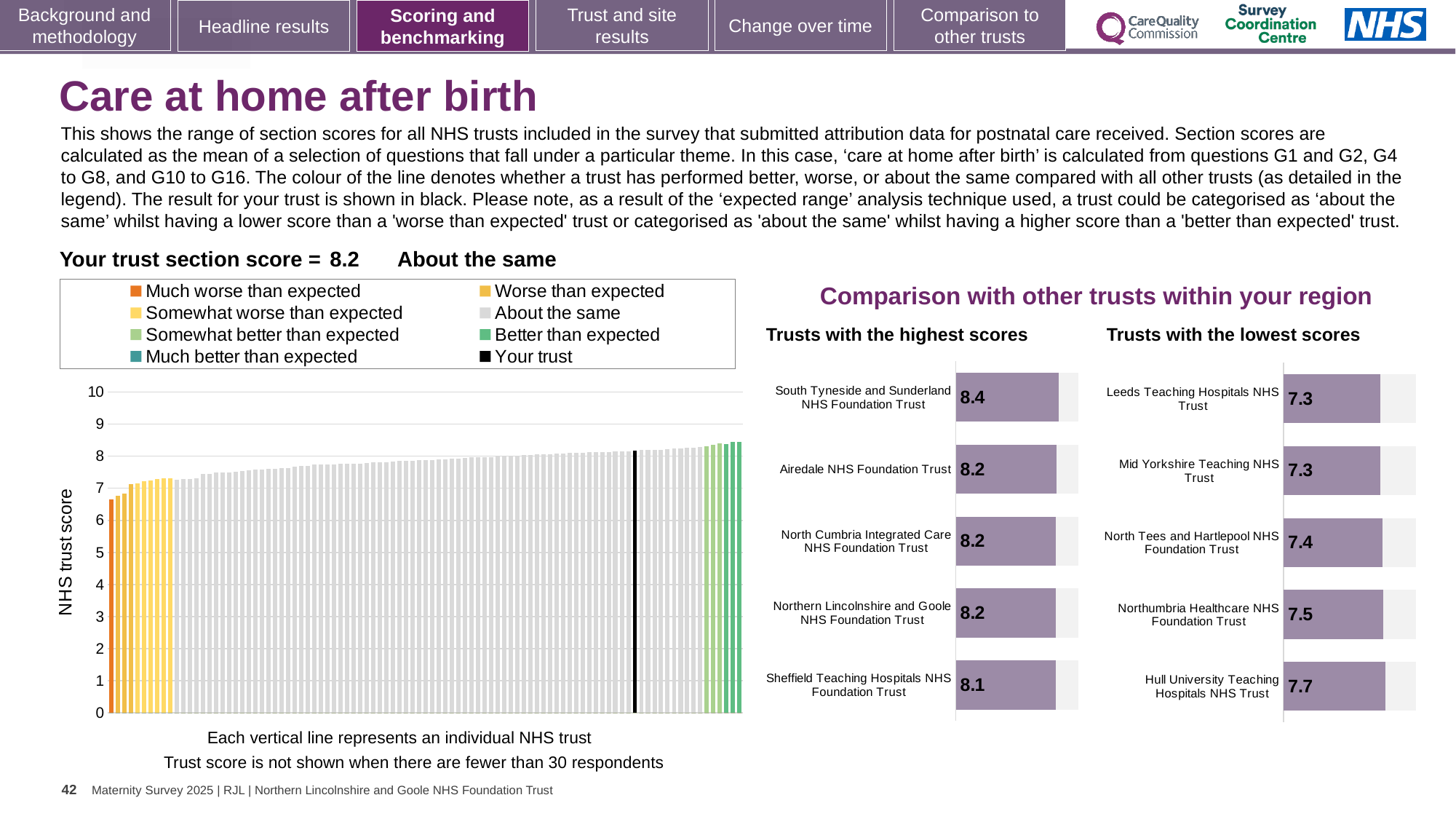
In the 'Trusts with the lowest scores' chart, what is the score for Hull University Teaching Hospitals NHS Trust? 7.7 In the 'Trusts with the highest scores' chart, what is the score for South Tyneside and Sunderland NHS Foundation Trust? 8.4 In the 'Trusts with the lowest scores' chart, what is the score for North Tees and Hartlepool NHS Foundation Trust? 7.4 In the 'Trusts with the lowest scores' chart, which trust has the highest score? Hull University Teaching Hospitals NHS Trust In the main 'NHS trust score' chart, what is the section score for your trust? 8.2 In the 'Trusts with the highest scores' chart, what is the score for Sheffield Teaching Hospitals NHS Foundation Trust? 8.1 What is the difference between the score for South Tyneside and Sunderland NHS Foundation Trust in the highest scores chart and the score for Leeds Teaching Hospitals NHS Trust in the lowest scores chart? 1.1 How many trusts are shown in the 'Trusts with the lowest scores' chart? 5 How many entries does the legend of the main 'NHS trust score' chart list? 8 In the main 'NHS trust score' chart, is the value of the leftmost bar greater or less than 7? less Which is larger: the score for Northumbria Healthcare NHS Foundation Trust in the lowest scores chart or the score for Airedale NHS Foundation Trust in the highest scores chart? Airedale NHS Foundation Trust In the 'Trusts with the highest scores' chart, which trust has the highest score? South Tyneside and Sunderland NHS Foundation Trust